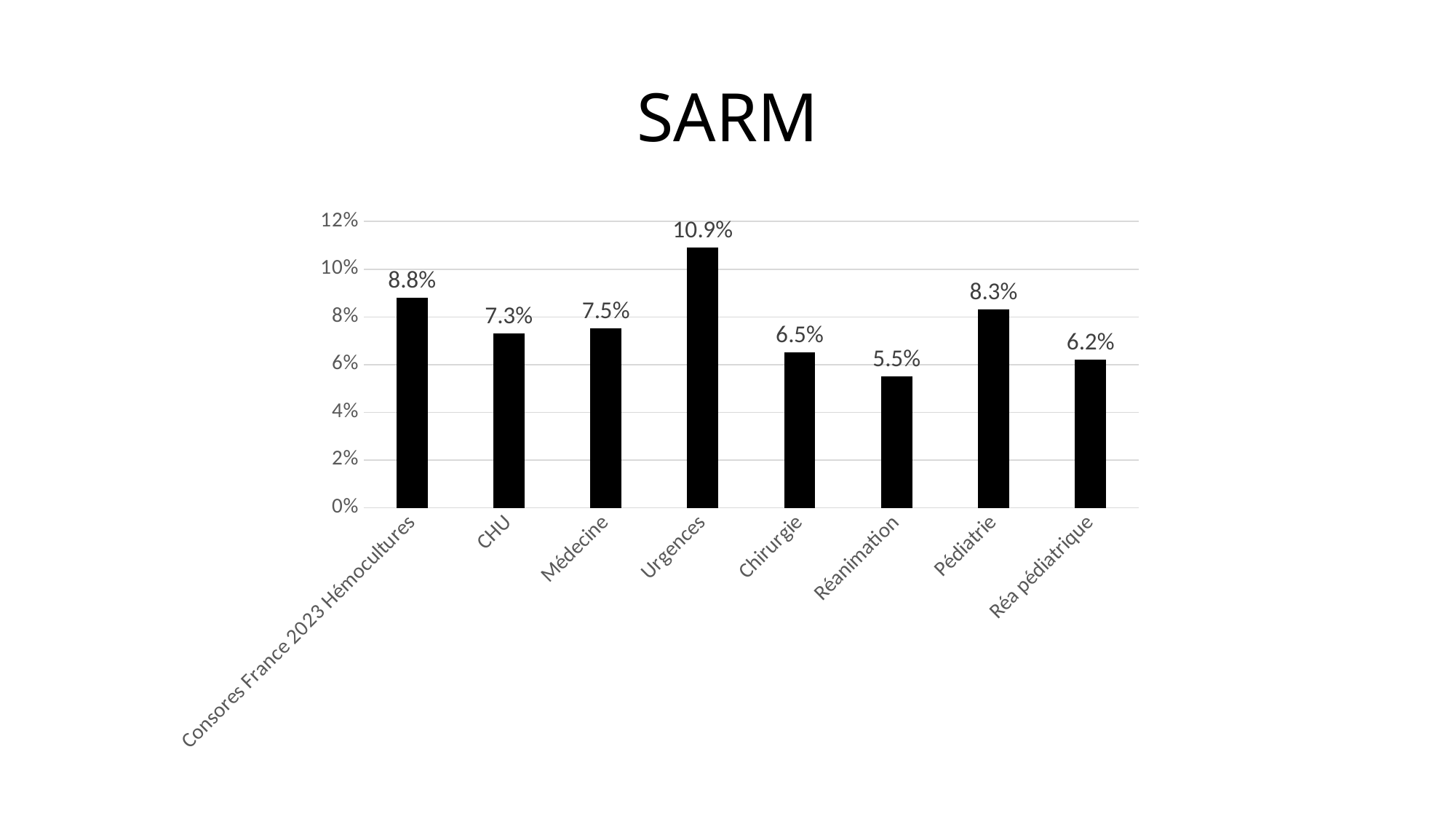
What is the value for Réanimation? 5.5% Which category has the highest value? Urgences What is the difference between the values for CHU and Médecine? 0.2% Which category has the lowest value? Réanimation What is the difference between the values for Urgences and Réanimation? 5.4% What kind of chart is shown on the slide? Bar chart Is the value for Pédiatrie greater or less than 8%? greater Which is larger, the value for Chirurgie or the value for Réa pédiatrique? Chirurgie How many categories are shown on the chart? 8 What is the value for Pédiatrie? 8.3% What is the value for Urgences? 10.9% What is the value for Consores France 2023 Hémocultures? 8.8%